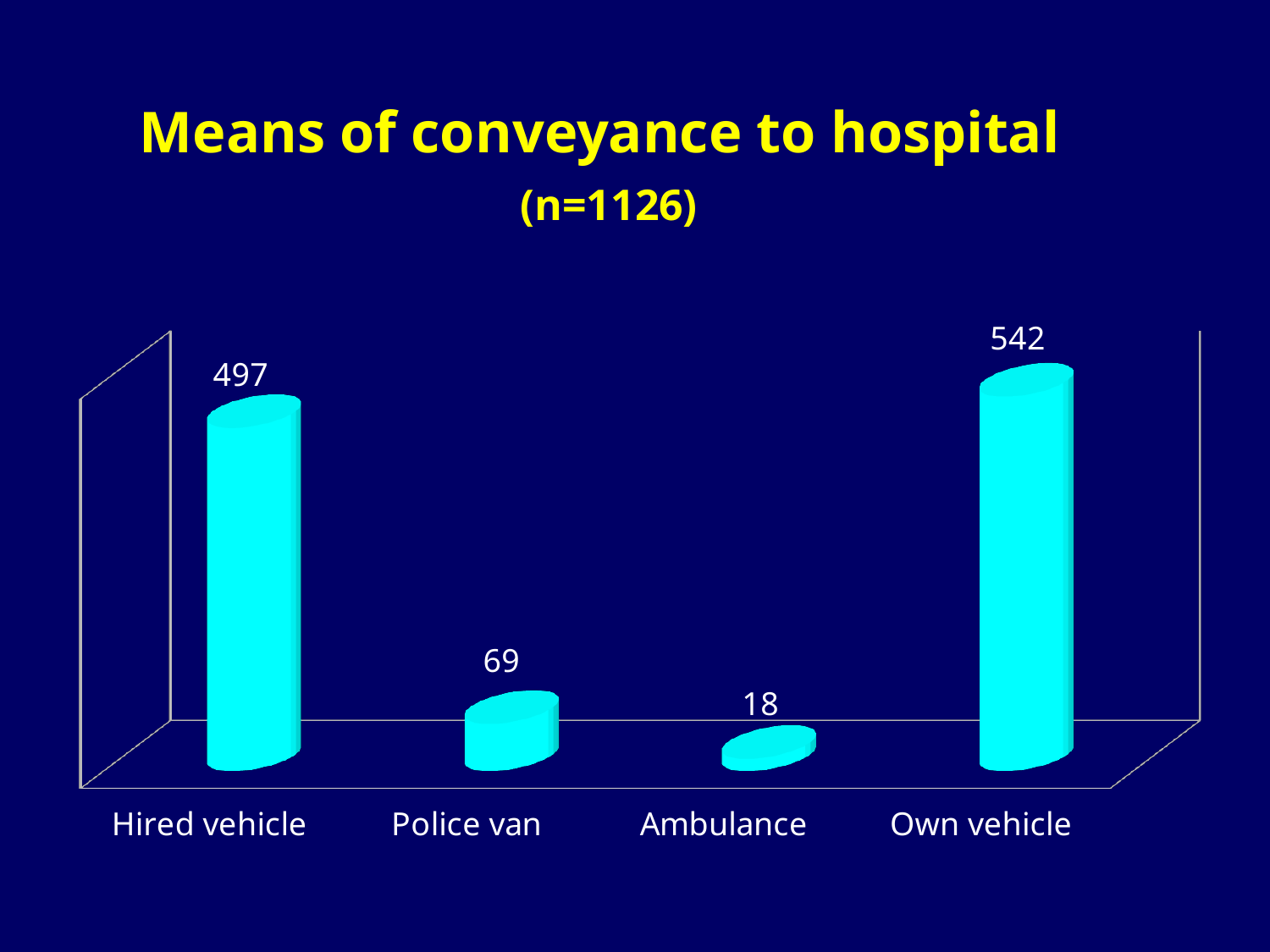
Which means of conveyance has the highest value? Own vehicle What is the value for Ambulance? 18 What is the value for Hired vehicle? 497 Which is larger, the value for Police van or the value for Ambulance? Police van What is the sample size (n) given in the chart title? 1126 What is the difference between the values for Police van and Ambulance? 51 What is the difference between the values for Own vehicle and Hired vehicle? 45 Which means of conveyance has the lowest value? Ambulance What is the value for Police van? 69 How many categories are shown in the chart? 4 What is the value for Own vehicle? 542 What kind of chart is shown on the slide? Bar chart